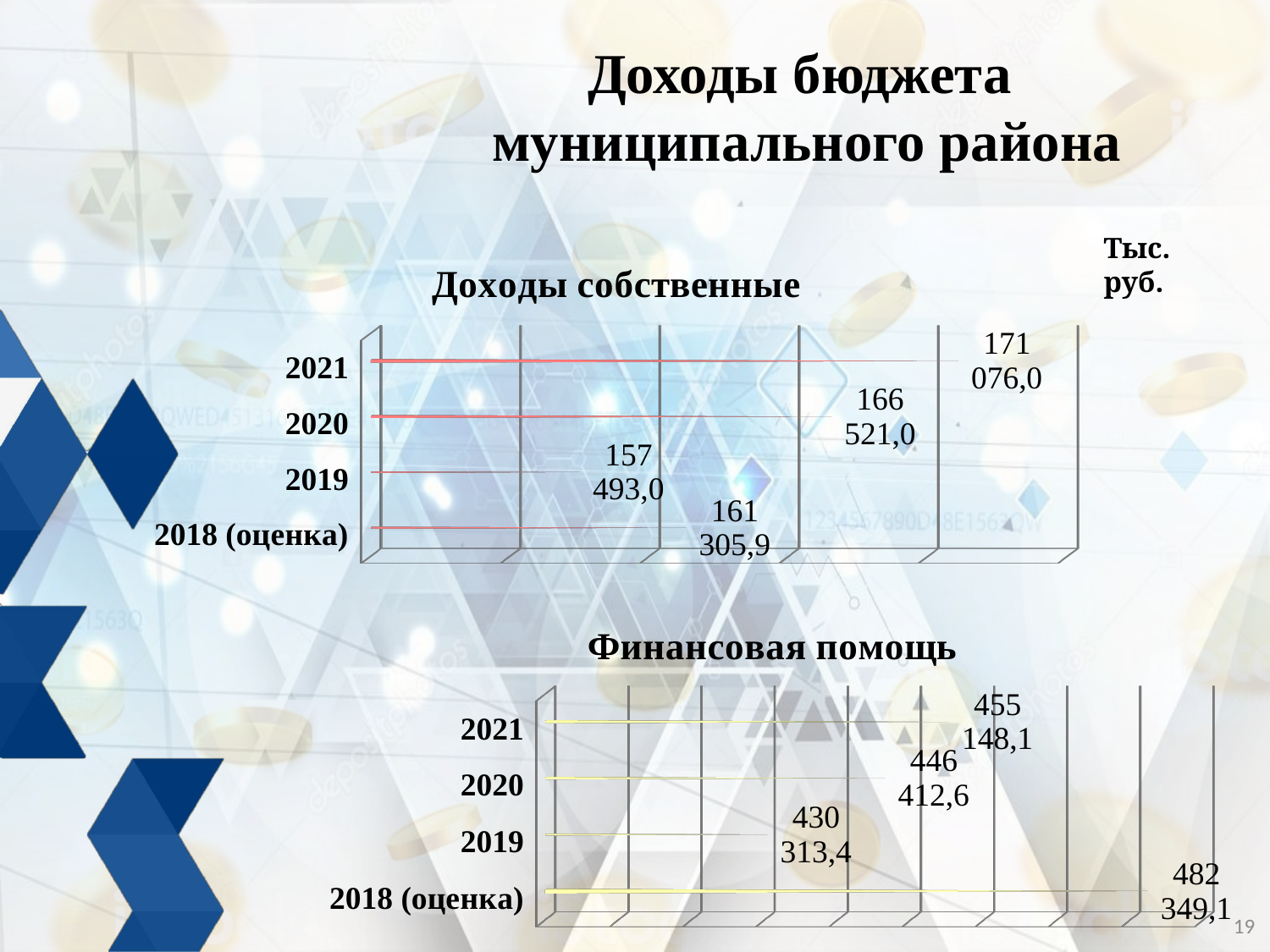
In the 'Финансовая помощь' chart, what is the value for 2019? 430 313,4 In the 'Доходы собственные' chart, which year has the lowest value? 2019 In the 'Доходы собственные' chart, which year has the highest value? 2021 In the 'Финансовая помощь' chart, what is the value for 2020? 446 412,6 In the 'Финансовая помощь' chart, which is larger: the value for 2021 or the value for 2020? 2021 What unit of measurement is indicated for the charts on the slide? Тыс. руб. In the 'Финансовая помощь' chart, which year has the highest value? 2018 (оценка) In the 'Доходы собственные' chart, what is the value for 2021? 171 076,0 In the 'Доходы собственные' chart, what is the difference between the 2021 and 2020 values? 4 555,0 In the 'Финансовая помощь' chart, what is the difference between the 2018 (оценка) and 2019 values? 52 035,7 In the 'Доходы собственные' chart, what is the value for 2018 (оценка)? 161 305,9 How many years are shown in the 'Финансовая помощь' chart? 4